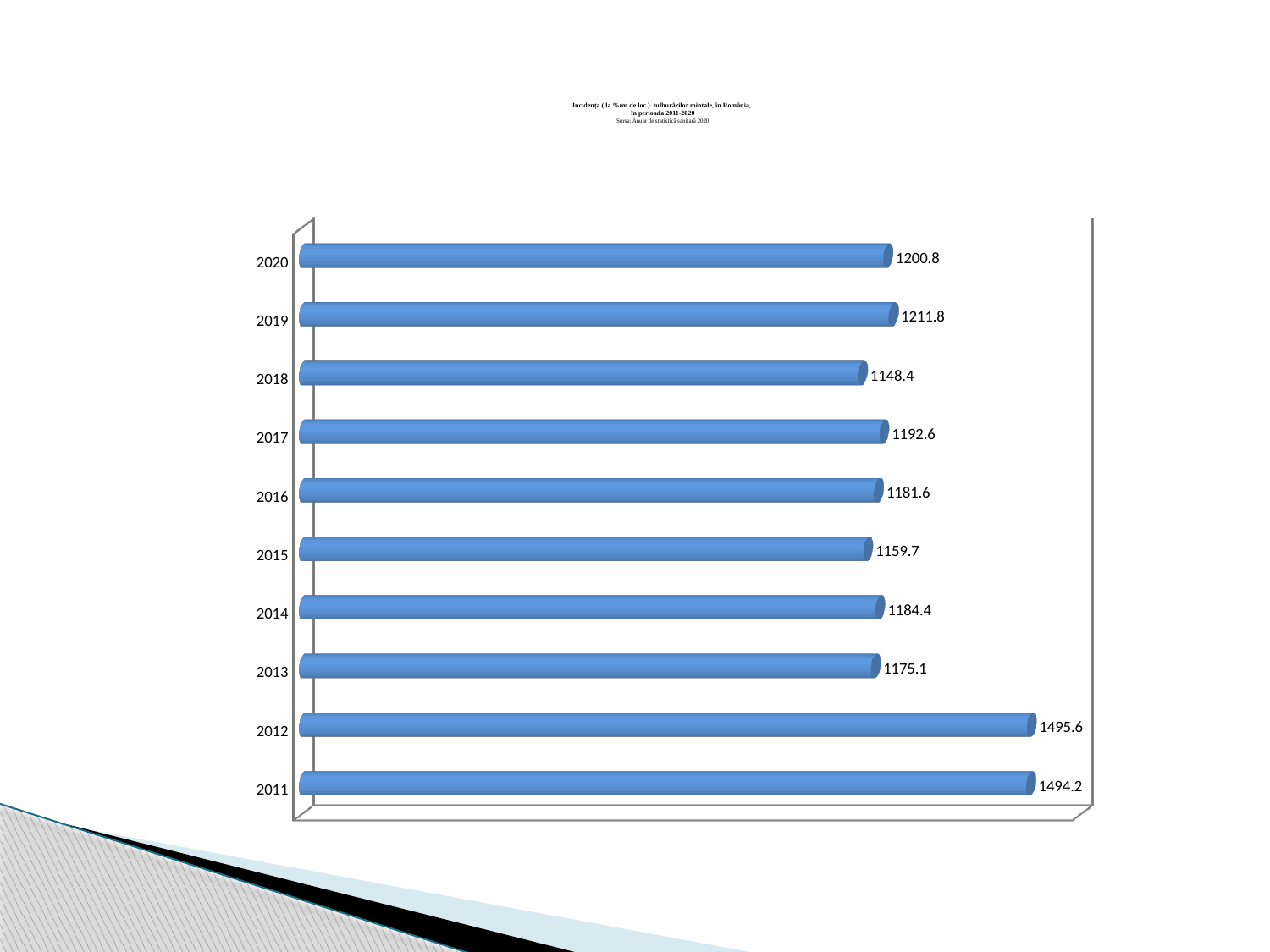
What is the difference between the values for 2012 and 2013? 320.5 Which year has the highest value? 2012 Overall, do the values rise or fall from 2011 to 2020? Fall What kind of chart is shown on the slide? Bar chart What is the value for 2012? 1495.6 What is the value for 2020? 1200.8 Which is larger, the value for 2016 or the value for 2014? 2014 Which year has the lowest value? 2018 What is the value for 2015? 1159.7 How many years are shown in the chart? 10 What is the difference between the values for 2019 and 2020? 11.0 What is the value for 2017? 1192.6